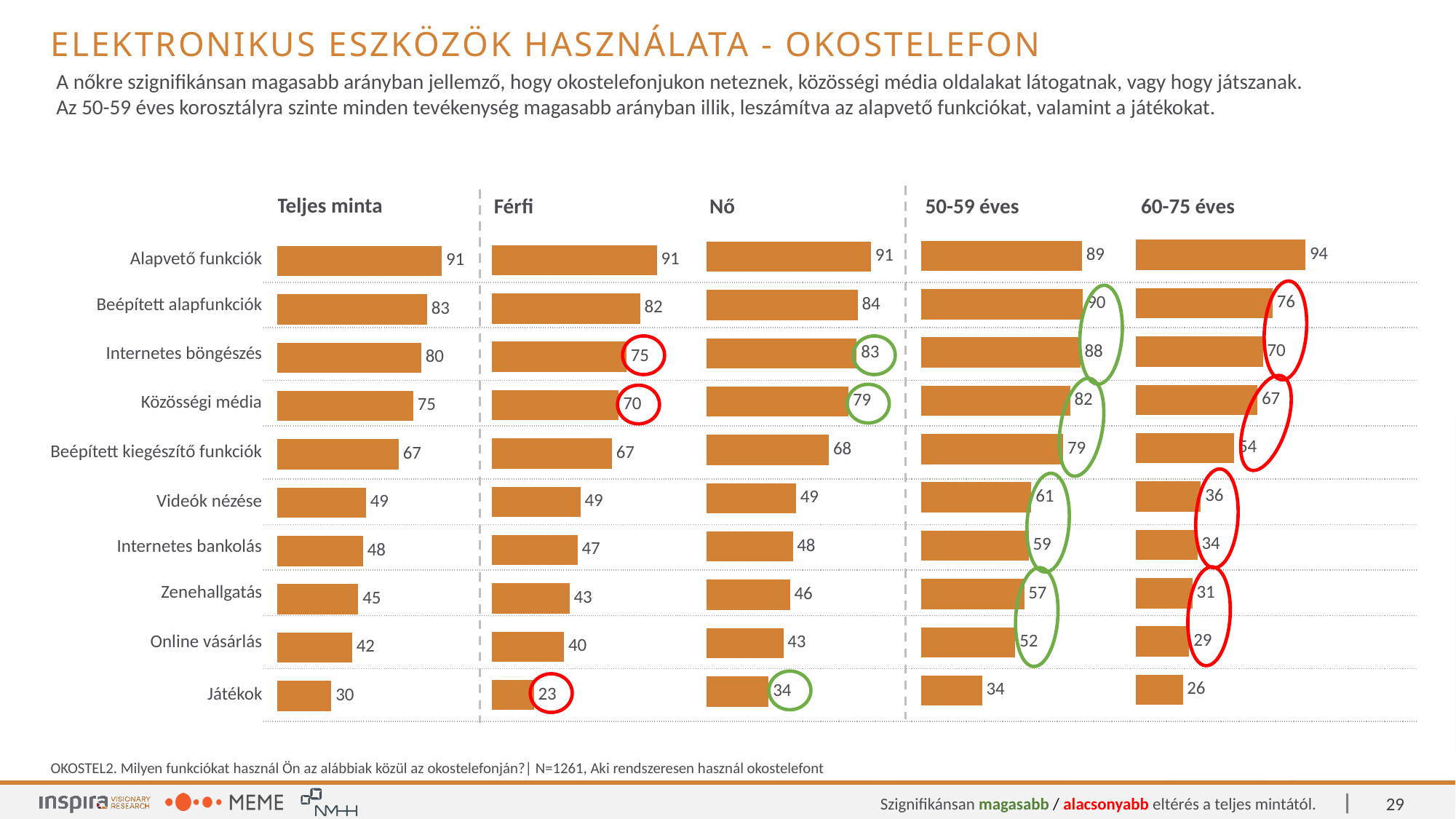
Which is larger: Internetes bankolás in the "50-59 éves" chart or Internetes bankolás in the "60-75 éves" chart? 50-59 éves In the "Nő" chart, what is the value for Közösségi média? 79 In the "50-59 éves" chart, which category has the lowest value? Játékok In the "Nő" chart, what is the difference between Alapvető funkciók and Játékok? 57 What kind of chart is the "Férfi" chart? Bar chart In the "Férfi" chart, what is the value for Játékok? 23 In the "50-59 éves" chart, what is the value for Videók nézése? 61 How many separate bar charts are shown on the slide? 5 In the "60-75 éves" chart, which category has the highest value? Alapvető funkciók In the "Teljes minta" chart, what is the value for Internetes böngészés? 80 In the "60-75 éves" chart, what is the difference between Beépített alapfunkciók and Online vásárlás? 47 How many categories are shown in the "Teljes minta" chart? 10